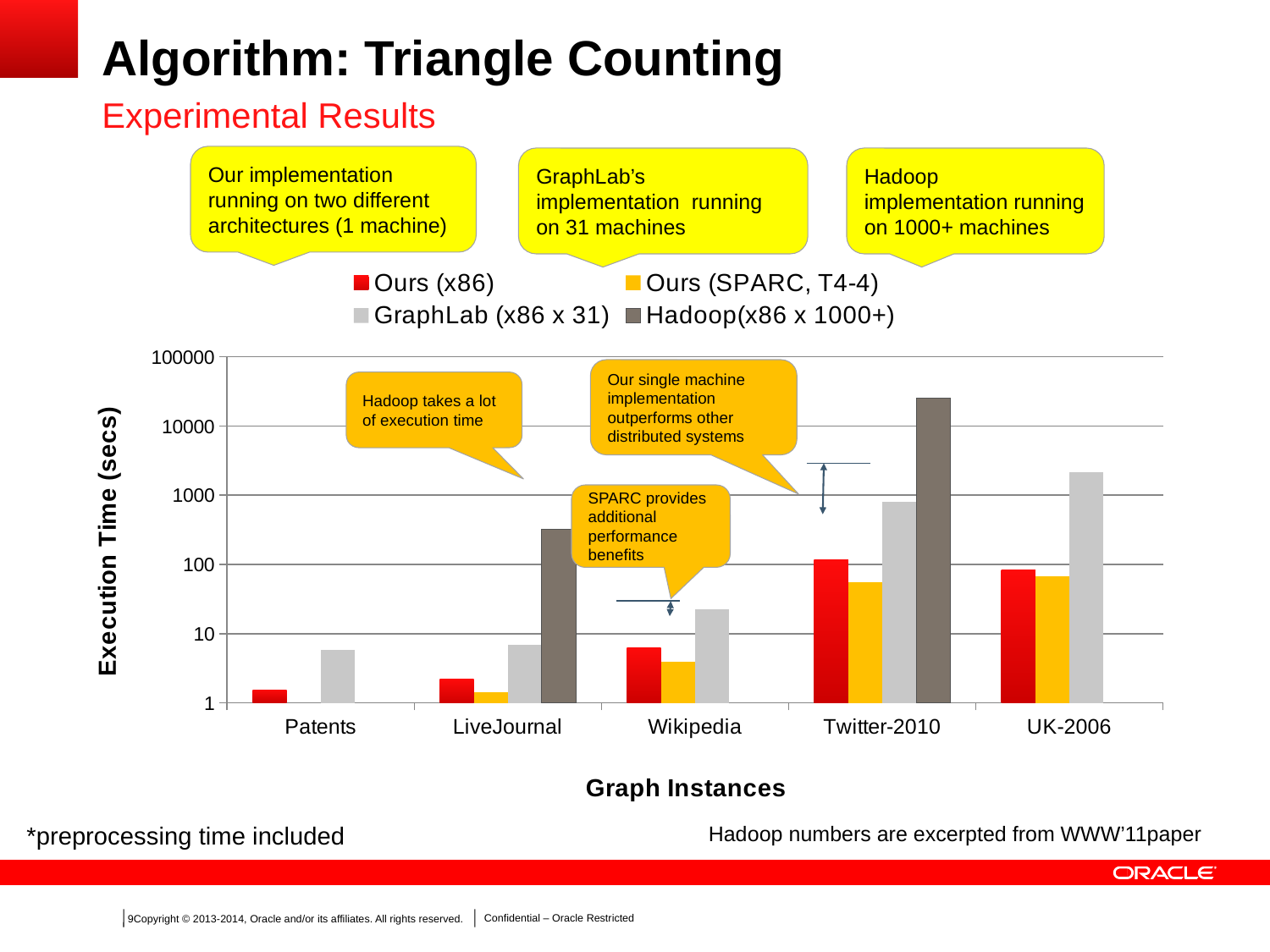
What kind of chart is shown on the slide? bar chart Is the Hadoop(x86 x 1000+) value for Twitter-2010 greater or less than 10000? greater How many graph instances (categories) are shown on the x axis? 5 Is the GraphLab (x86 x 31) value for UK-2006 greater or less than 1000? greater For Twitter-2010, which series has the highest execution time? Hadoop(x86 x 1000+) Is the Ours (SPARC, T4-4) value for Twitter-2010 greater or less than 100? less What is the title of the y axis? Execution Time (secs) What is the title of the x axis? Graph Instances How many series does the legend list? 4 For Wikipedia, which is larger: Ours (x86) or Ours (SPARC, T4-4)? Ours (x86)